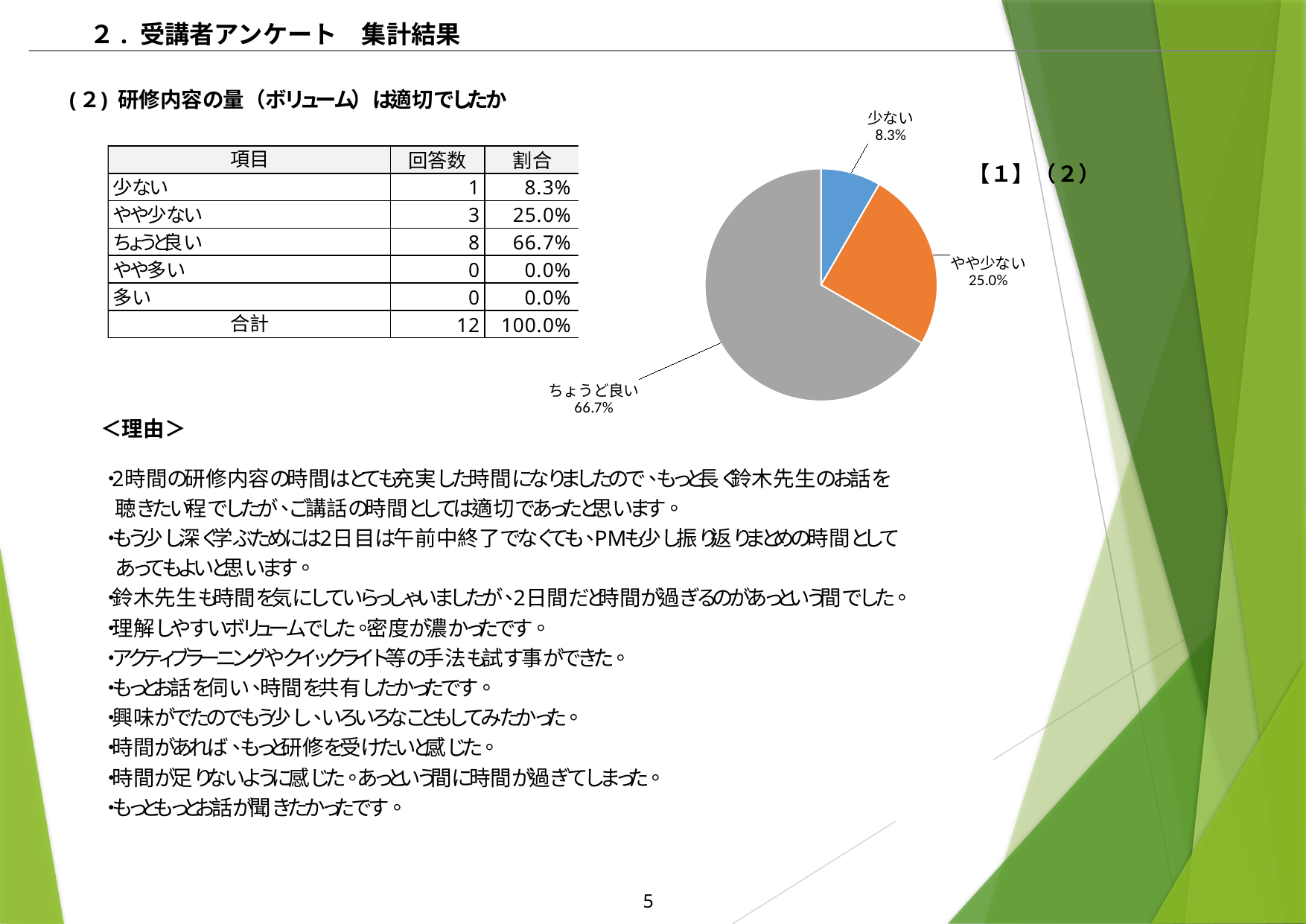
What is the difference in percentage points between the ちょうど良い slice and the やや少ない slice? 41.7 What share of the pie does the ちょうど良い slice represent? 66.7% What colour is the ちょうど良い slice in the pie chart? gray Which slice of the pie chart is the largest? ちょうど良い Which is larger in the pie chart, やや少ない or 少ない? やや少ない What colour is the 少ない slice in the pie chart? blue Which slice of the pie chart is the smallest? 少ない What is the difference in percentage points between the やや少ない slice and the 少ない slice? 16.7 What share of the pie does the 少ない slice represent? 8.3% How many labeled slices does the pie chart have? 3 What kind of chart is shown on the slide? pie chart What share of the pie does the やや少ない slice represent? 25.0%